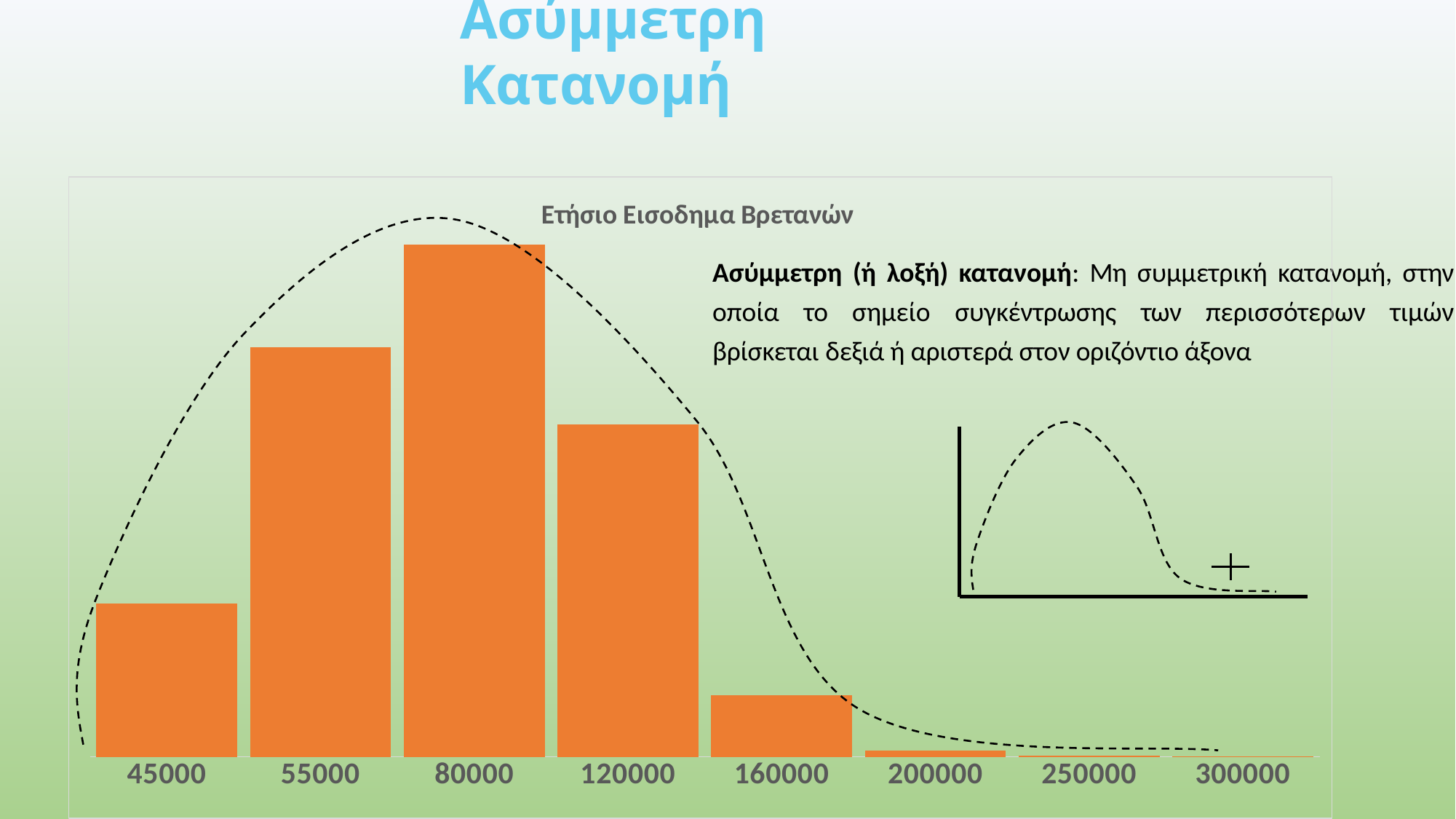
Which bar is taller, 55000 or 120000? 55000 Which bar is taller, 45000 or 160000? 45000 Do the bars rise or fall from 45000 to 80000 along the x axis? rise What is the title of the chart? Ετήσιο Εισοδημα Βρετανών Which bar is taller, 45000 or 55000? 55000 Do the bars rise or fall from 80000 to 300000 along the x axis? fall Which category has the tallest bar? 80000 What colour are the bars in the chart? orange What kind of chart is shown on the slide? bar chart How many categories are shown on the x axis of the chart? 8 What is the first category label on the x axis? 45000